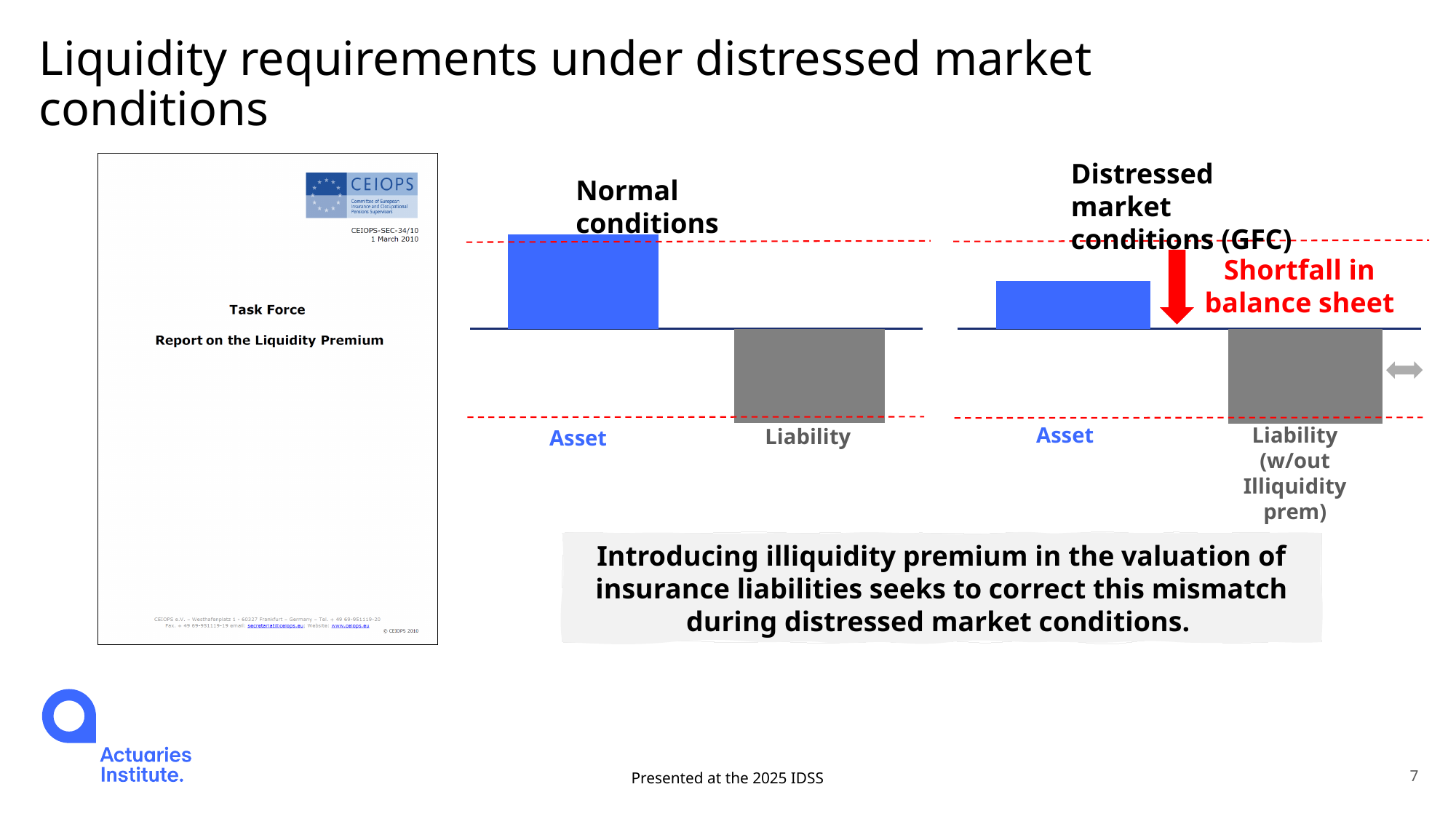
In the "Distressed market conditions (GFC)" chart, which bar is taller, Asset or Liability? Liability Is the Asset bar taller in the "Normal conditions" chart or in the "Distressed market conditions (GFC)" chart? Normal conditions How many bars are shown in the "Normal conditions" chart? 2 What kind of chart is shown under the heading "Normal conditions"? bar chart What colour is the Asset bar in the "Normal conditions" chart? Blue How many charts are shown on the slide? 2 What is the full label of the grey bar in the "Distressed market conditions (GFC)" chart? Liability (w/out Illiquidity prem) What are the two category labels in the "Normal conditions" chart? Asset and Liability What does the red arrow in the "Distressed market conditions (GFC)" chart indicate? Shortfall in balance sheet How many bars are shown in the "Distressed market conditions (GFC)" chart? 2